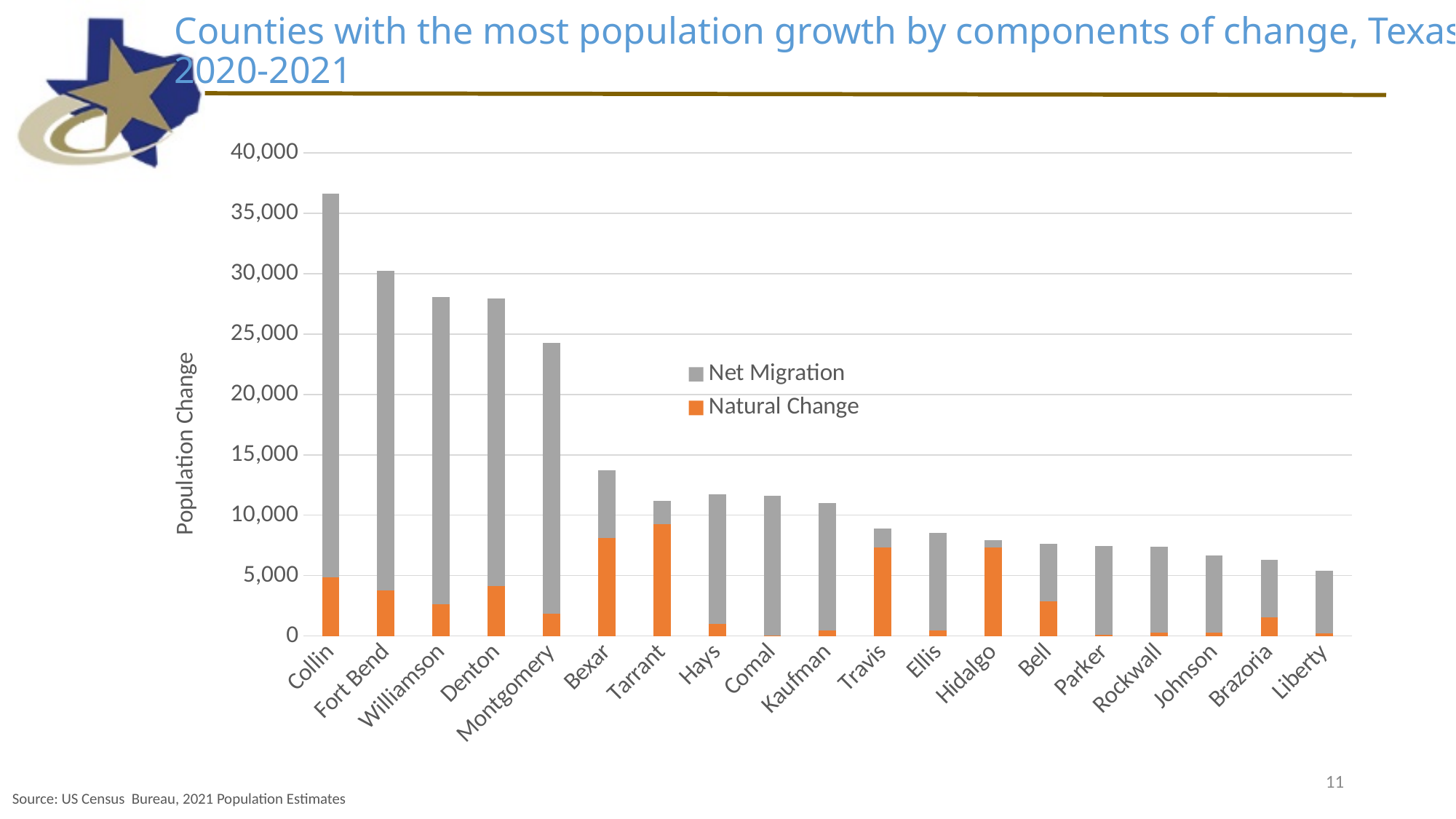
Is the total population change for Williamson greater or less than 30,000? less How many series does the chart's legend list? 2 How many counties are shown on the x axis of the chart? 19 Which county has the lowest total population change in the chart? Liberty Which county has the largest Natural Change segment? Tarrant What kind of chart is shown on the slide? stacked bar chart What are the two series named in the chart's legend? Net Migration and Natural Change Is the total population change for Bexar greater or less than 15,000? less Is the total population change for Collin greater or less than 35,000? greater Which county has the highest total population change in the chart? Collin Do the total bar heights rise or fall moving from left to right along the x axis? fall Which county has a larger total population change, Collin or Fort Bend? Collin